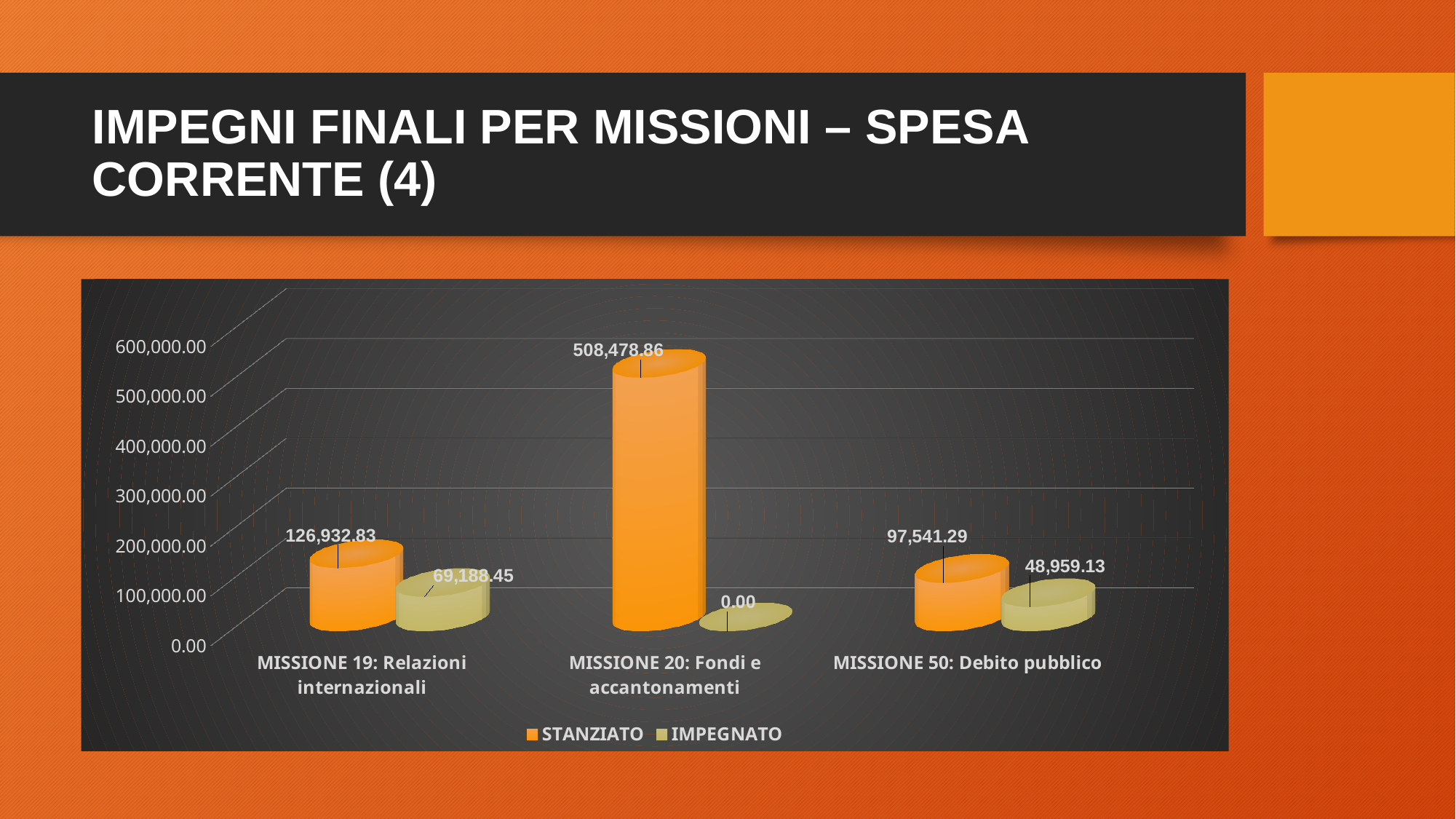
What kind of chart is shown on the slide? Bar chart Which category has the highest STANZIATO value? MISSIONE 20: Fondi e accantonamenti What is the STANZIATO value for MISSIONE 20: Fondi e accantonamenti? 508,478.86 What is the difference between the STANZIATO and IMPEGNATO values for MISSIONE 19: Relazioni internazionali? 57,744.38 What is the IMPEGNATO value for MISSIONE 19: Relazioni internazionali? 69,188.45 How many series does the legend list? 2 Which category has the lowest IMPEGNATO value? MISSIONE 20: Fondi e accantonamenti What is the IMPEGNATO value for MISSIONE 50: Debito pubblico? 48,959.13 How many categories are shown on the x axis? 3 Which is larger, the STANZIATO value for MISSIONE 19: Relazioni internazionali or the STANZIATO value for MISSIONE 50: Debito pubblico? MISSIONE 19: Relazioni internazionali What is the STANZIATO value for MISSIONE 50: Debito pubblico? 97,541.29 What is the difference between the STANZIATO and IMPEGNATO values for MISSIONE 50: Debito pubblico? 48,582.16